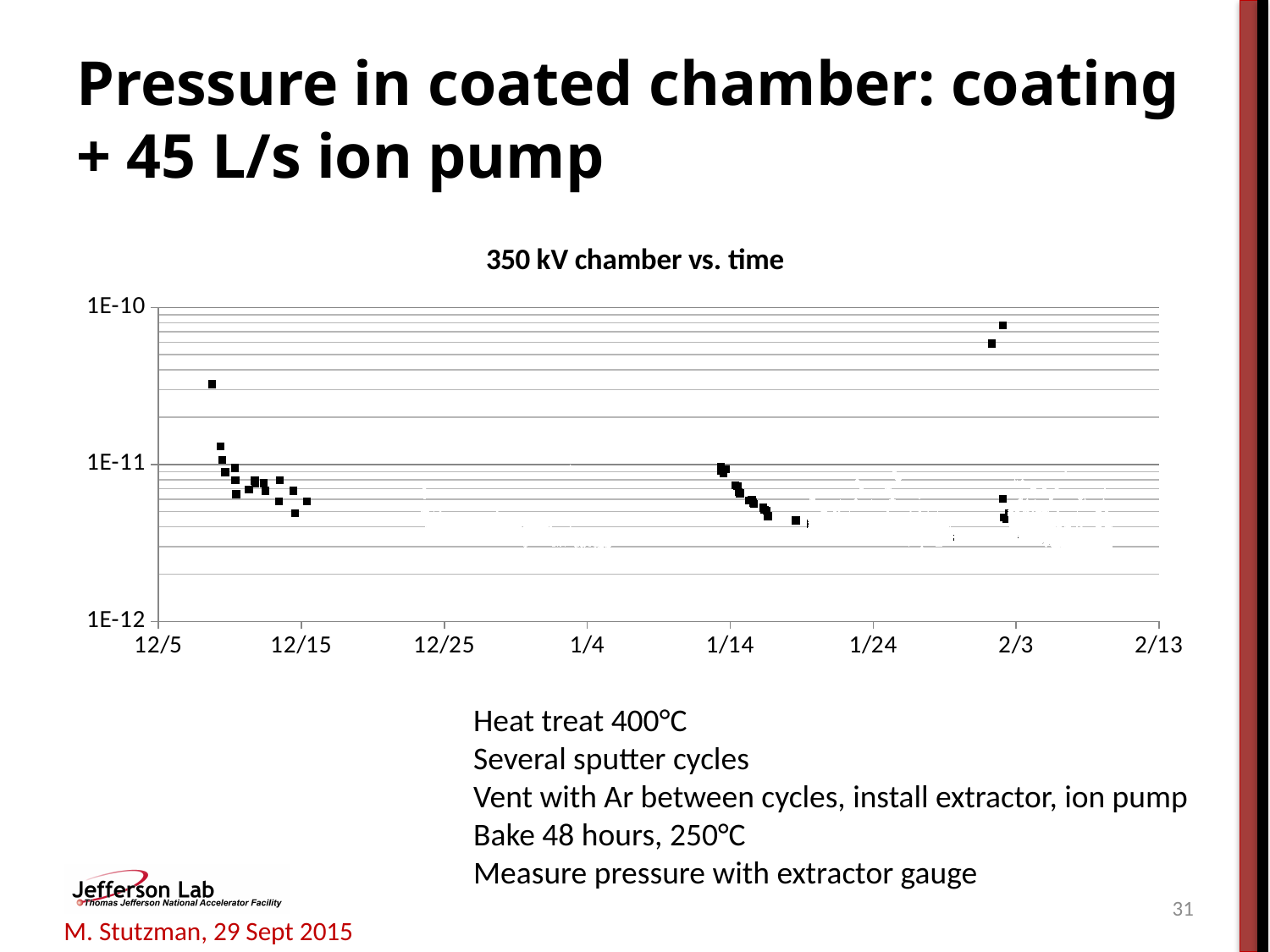
What is the lowest value labelled on the y axis of the chart? 1E-12 Which is larger: the highest point near 2/3 or the highest point near 1/14? the highest point near 2/3 What kind of chart is shown on the slide? scatter chart Within the cluster of points starting at 1/14, do the values rise or fall as time goes on? fall How many date labels are shown along the x axis of the chart? 8 What is the first date label on the x axis of the chart? 12/5 Is the lowest data point plotted near 12/15 greater or less than 1E-12? greater Are the data points plotted around 1/14 to 1/19 greater or less than 1E-10? less Is the first data point plotted (just after 12/5) greater or less than 1E-11? greater What is the title of the chart? 350 kV chamber vs. time